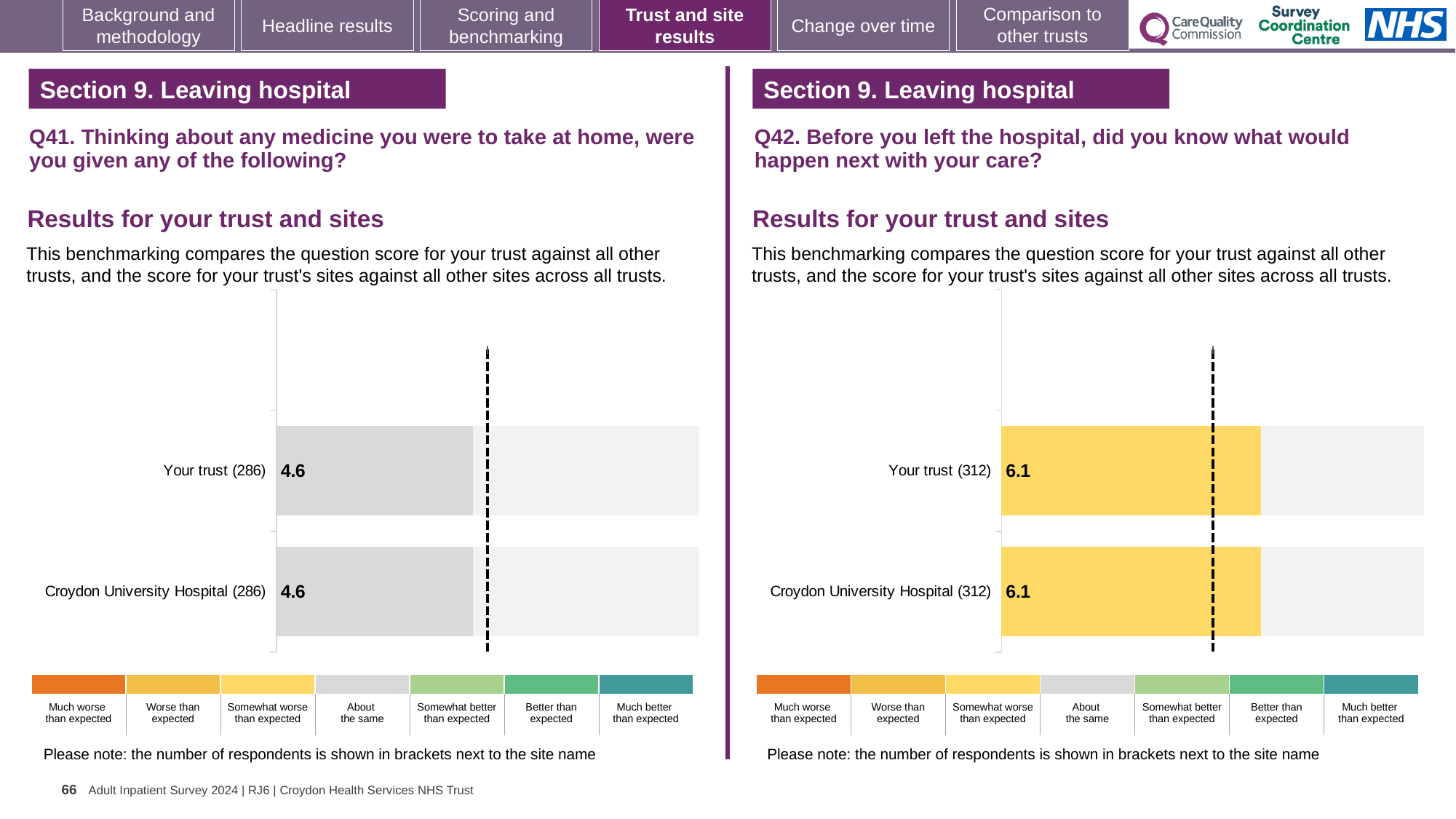
How many bars are plotted in the Q42 chart on the right? 2 In the Q41 chart on the left, what is the score for Your trust? 4.6 In the Q41 chart on the left, how many respondents are shown in brackets next to Your trust? 286 What kind of chart is used for the Q42 results on the right? Bar chart In the Q41 chart on the left, what is the score for Croydon University Hospital? 4.6 In the Q41 chart on the left, what is the difference between the score for Your trust and the score for Croydon University Hospital? 0 In the Q42 chart on the right, what is the score for Your trust? 6.1 According to the colour key, which benchmark category do the yellow bars in the Q42 chart on the right represent? Somewhat worse than expected How many bars are plotted in the Q41 chart on the left? 2 In the Q42 chart on the right, what is the difference between the score for Your trust and the score for Croydon University Hospital? 0 In the Q42 chart on the right, how many respondents are shown in brackets next to Croydon University Hospital? 312 In the Q42 chart on the right, what is the score for Croydon University Hospital? 6.1